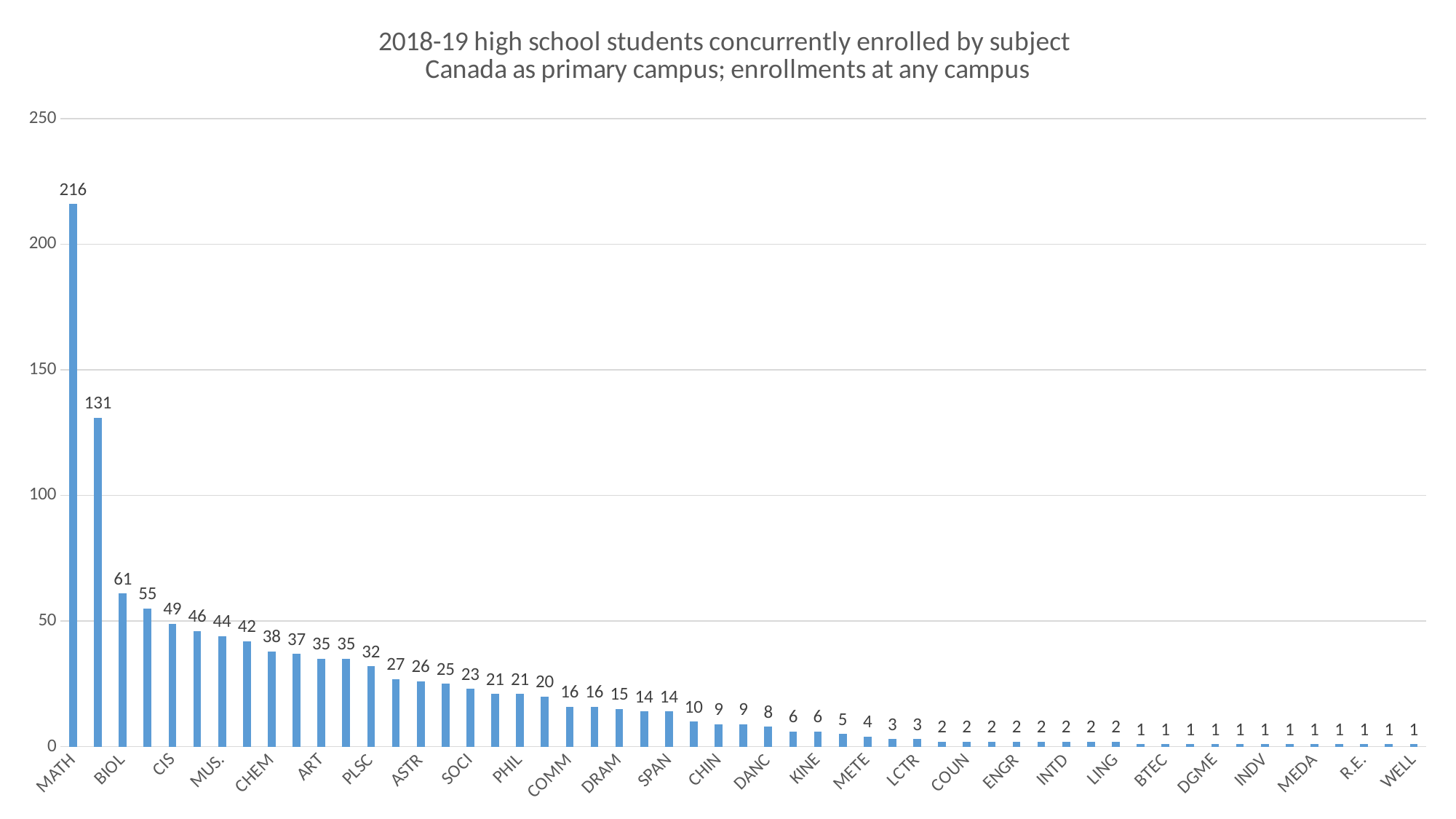
What kind of chart is shown on the slide? Bar chart Which subject has the highest number of enrolled students? MATH Which is larger, the value for CIS or the value for MUS.? CIS Is the value for BIOL greater or less than 100? less Do the values rise or fall moving from left to right along the x axis? Fall What is the difference between the values for MATH and BIOL? 155 What is the value for MATH? 216 What is the value for BIOL? 61 What is the first line of the chart's title? 2018-19 high school students concurrently enrolled by subject What is the value for PHIL? 21 What is the value for CIS? 49 What is the value for CHEM? 38